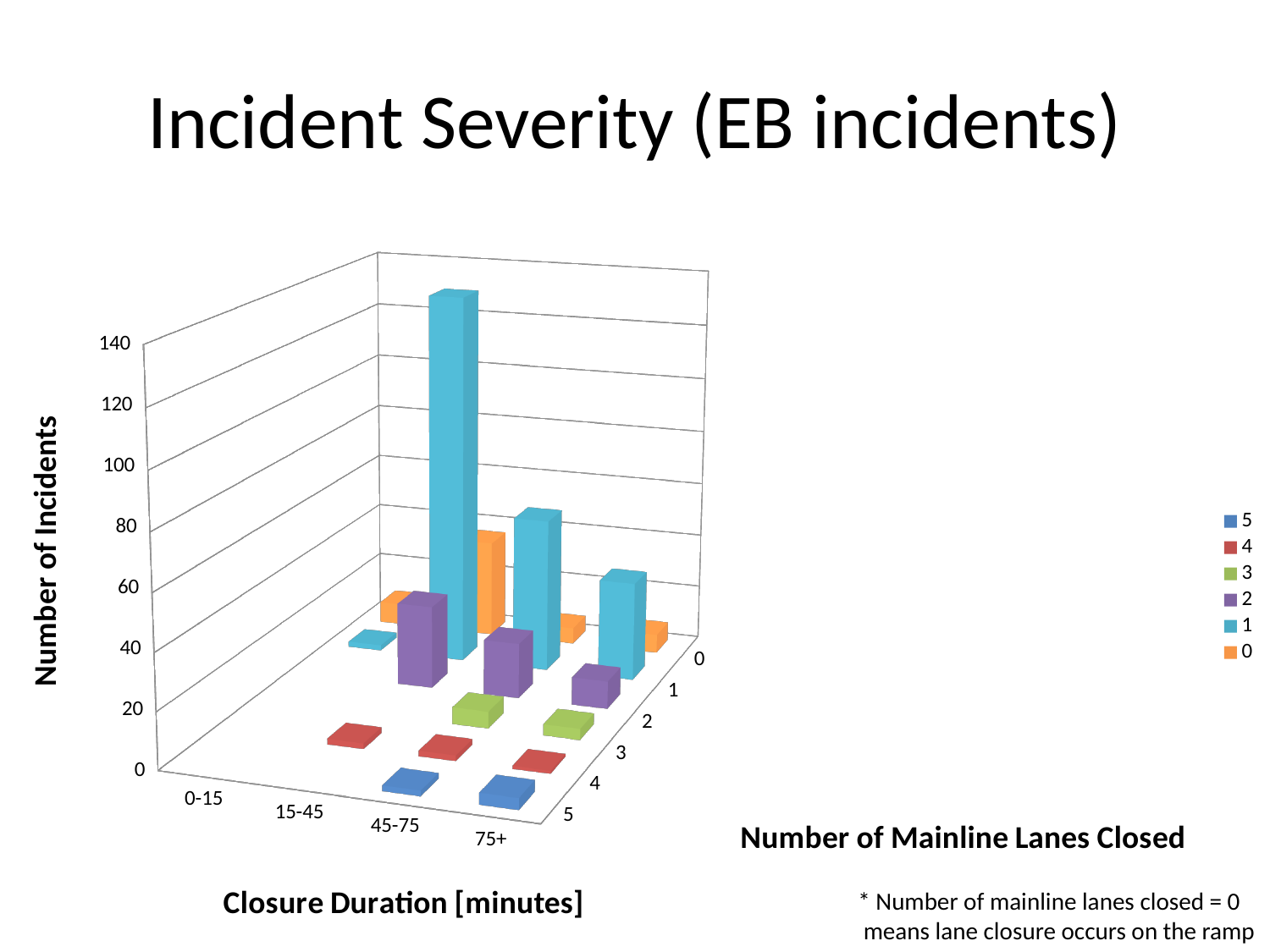
What kind of chart is shown on the slide? bar chart What is the title of the chart? Incident Severity (EB incidents) How many closure duration categories are shown on the x axis? 4 Is the number of incidents for 1 lane closed in the 15-45 minute category greater or less than 100? greater For 1 mainline lane closed, which closure duration has the highest number of incidents? 15-45 For 1 mainline lane closed, do the values rise or fall from 15-45 to 75+ minutes? fall What is the label of the vertical axis? Number of Incidents How many series does the legend list? 6 For 1 mainline lane closed, which is larger: the 15-45 minute bar or the 45-75 minute bar? 15-45 Is the number of incidents for 5 lanes closed in the 75+ minute category greater or less than 40? less Which number of mainline lanes closed has the tallest bar on the chart? 1 Is the number of incidents for 1 lane closed in the 0-15 minute category greater or less than 40? less